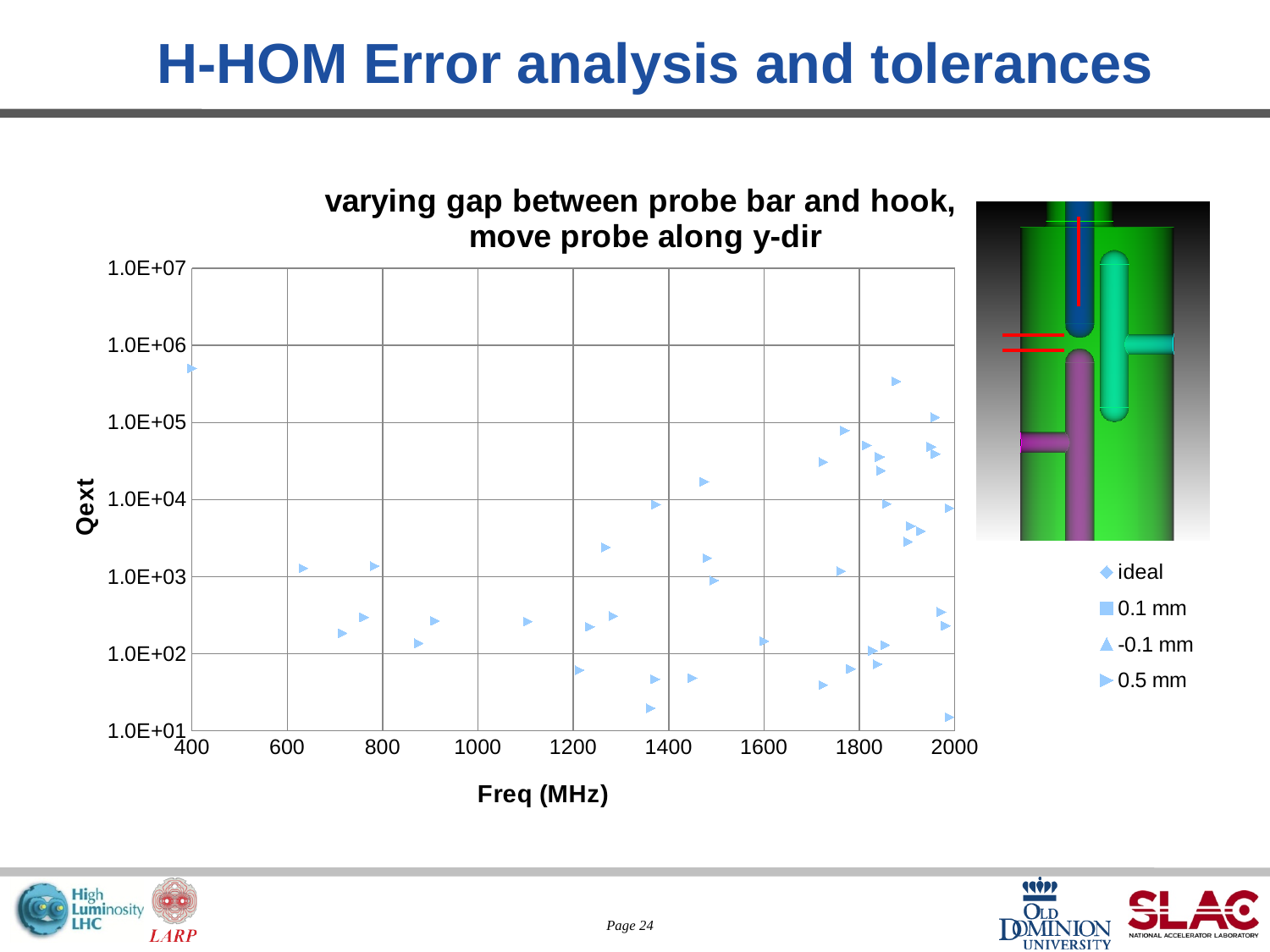
What is the title of the chart? varying gap between probe bar and hook, move probe along y-dir What is the lowest value shown on the x axis of the chart? 400 What is the highest value shown on the x axis of the chart? 2000 How many series does the chart legend list? 4 Is the highest plotted Qext value on the chart greater or less than 1.0E+06? less Is the Qext value of the point plotted near 400 MHz greater or less than 1.0E+05? greater Is the lowest plotted Qext value on the chart greater or less than 1.0E+02? less What kind of chart is shown on the slide? scatter chart